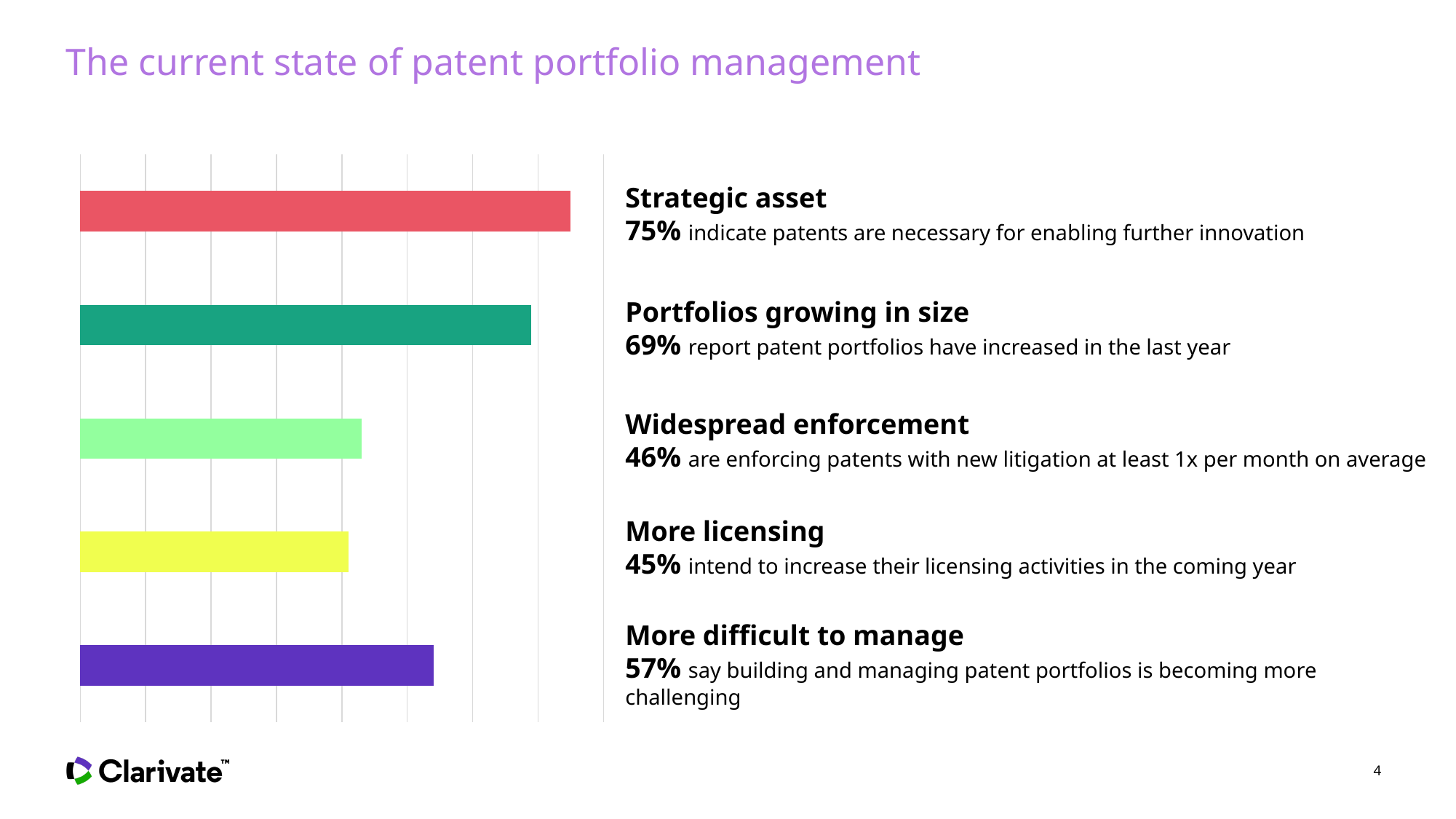
What percentage is shown for More difficult to manage? 57% Which category has the longest bar? Strategic asset What colour is the bar for More difficult to manage? purple Which category has the shortest bar? More licensing Which is larger, the value for Portfolios growing in size or the value for More difficult to manage? Portfolios growing in size What is the difference between the Strategic asset value and the More licensing value? 30% What percentage is shown for Portfolios growing in size? 69% What is the difference between the Portfolios growing in size value and the Widespread enforcement value? 23% How many bars does the chart contain? 5 What percentage is shown for Widespread enforcement? 46% What kind of chart is shown on the slide? bar chart What percentage is shown for Strategic asset? 75%